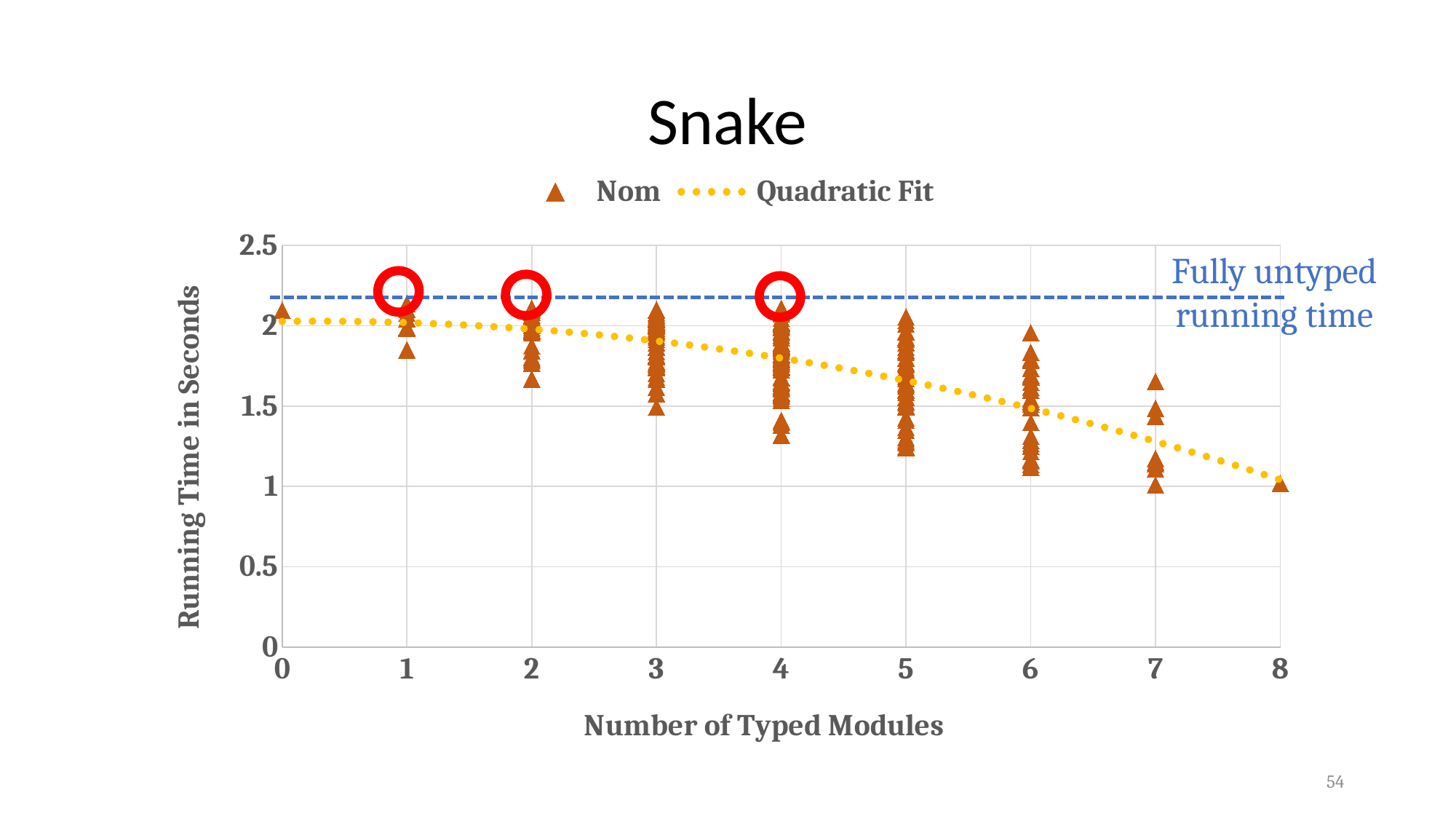
Which is larger, the Quadratic Fit value at 2 typed modules or at 6 typed modules? 2 typed modules Are all Nom values at 7 typed modules greater or less than 2? less Is the Nom value at 0 typed modules greater or less than 1.5? greater At which number of typed modules is the Quadratic Fit value lowest? 8 At which number of typed modules is the Quadratic Fit value highest? 0 Does the Quadratic Fit line rise or fall as the number of typed modules increases? fall Is the Quadratic Fit value at 8 typed modules greater or less than 1.5? less What kind of chart is shown on the slide? scatter chart What is the title of the chart? Snake How many series does the legend list? 2 How many tick values are labeled on the x axis (Number of Typed Modules)? 9 What are the two series named in the legend? Nom and Quadratic Fit